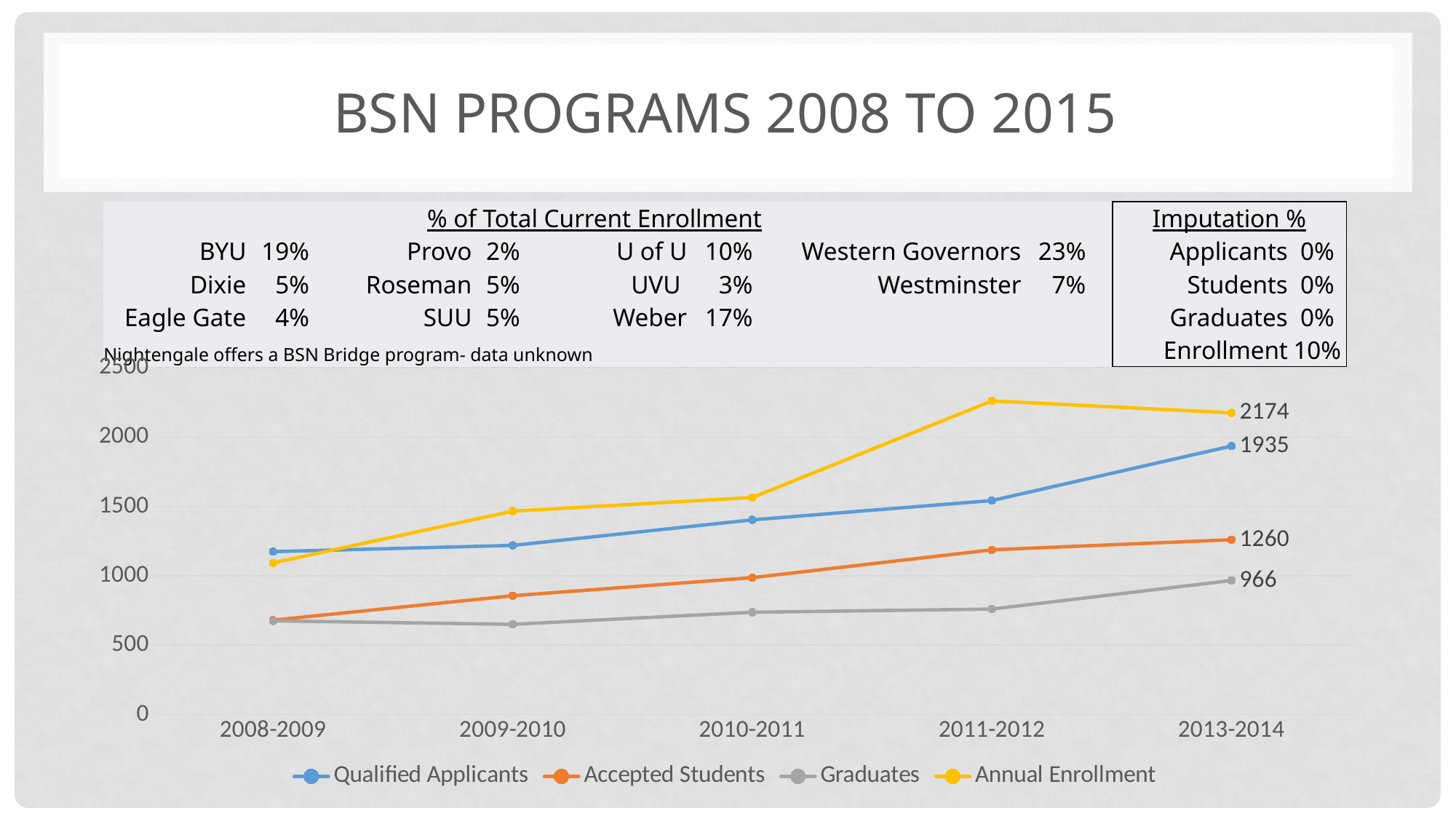
Does the Qualified Applicants line rise or fall from 2008-2009 to 2013-2014? rise Is the value for Annual Enrollment in 2011-2012 greater or less than 2000? greater What is the value for Graduates in 2013-2014? 966 What is the difference between Qualified Applicants and Accepted Students in 2013-2014? 675 What is the value for Annual Enrollment in 2013-2014? 2174 What is the value for Qualified Applicants in 2013-2014? 1935 Which is larger in 2011-2012, Accepted Students or Graduates? Accepted Students What is the value for Accepted Students in 2013-2014? 1260 How many series does the chart legend list? 4 Which series has the highest value in 2013-2014? Annual Enrollment What is the difference between Annual Enrollment and Graduates in 2013-2014? 1208 What kind of chart is shown on the slide? line chart